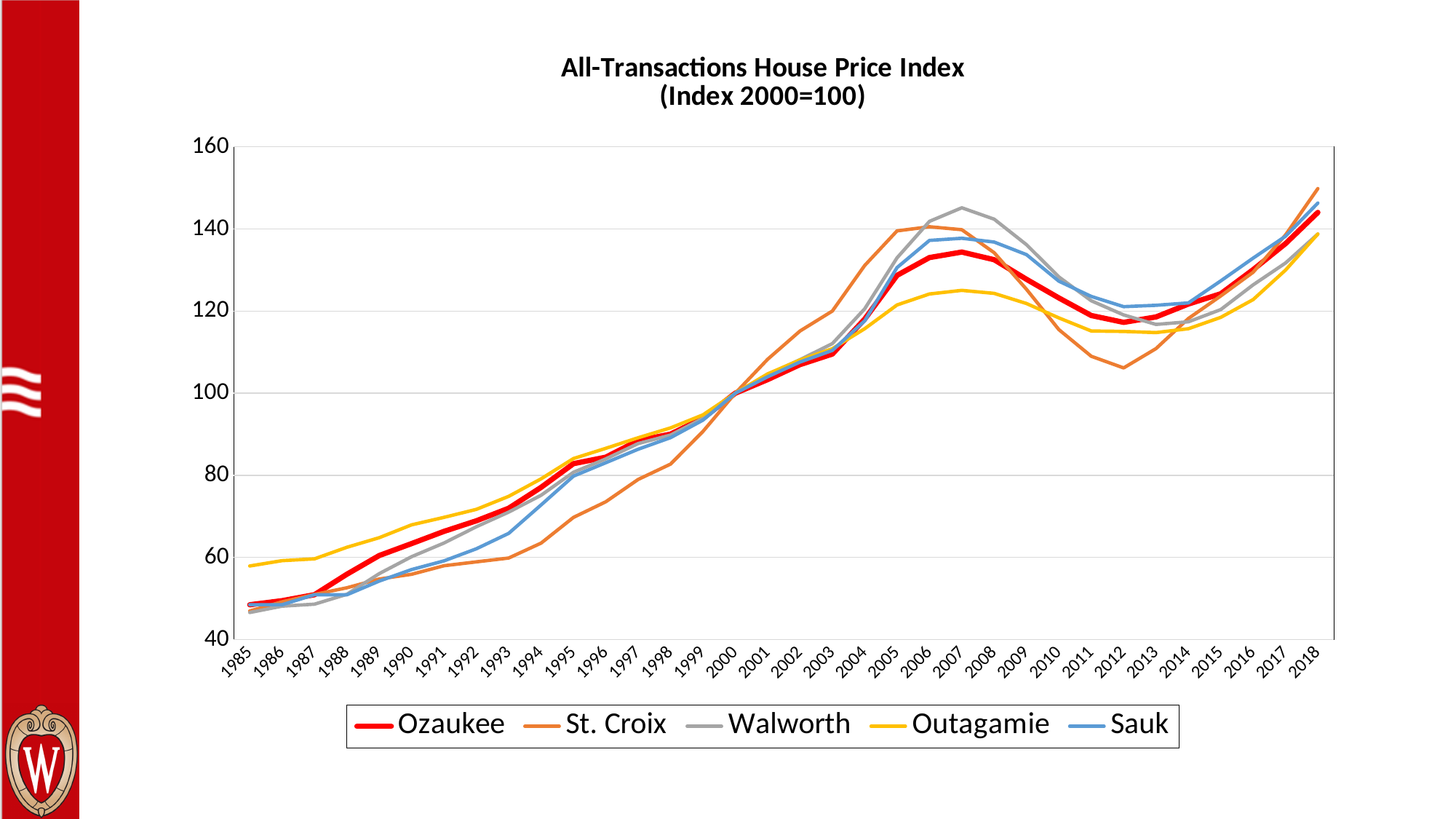
What kind of chart is shown on the slide? line chart Which series has the lowest value in 2012? St. Croix What is the value of the Ozaukee series in 2000? 100 What is the title of the chart? All-Transactions House Price Index (Index 2000=100) Is the value for St. Croix in 2012 greater or less than 120? less Is the value for Sauk in 1993 greater or less than 80? less How many series does the legend list? 5 Does the St. Croix series rise or fall from 2007 to 2012? fall In 2007, which is larger: Walworth or Outagamie? Walworth Which series has the highest value in 2018? St. Croix How many years are plotted along the x axis? 34 Is the value for Walworth in 2007 greater or less than 140? greater